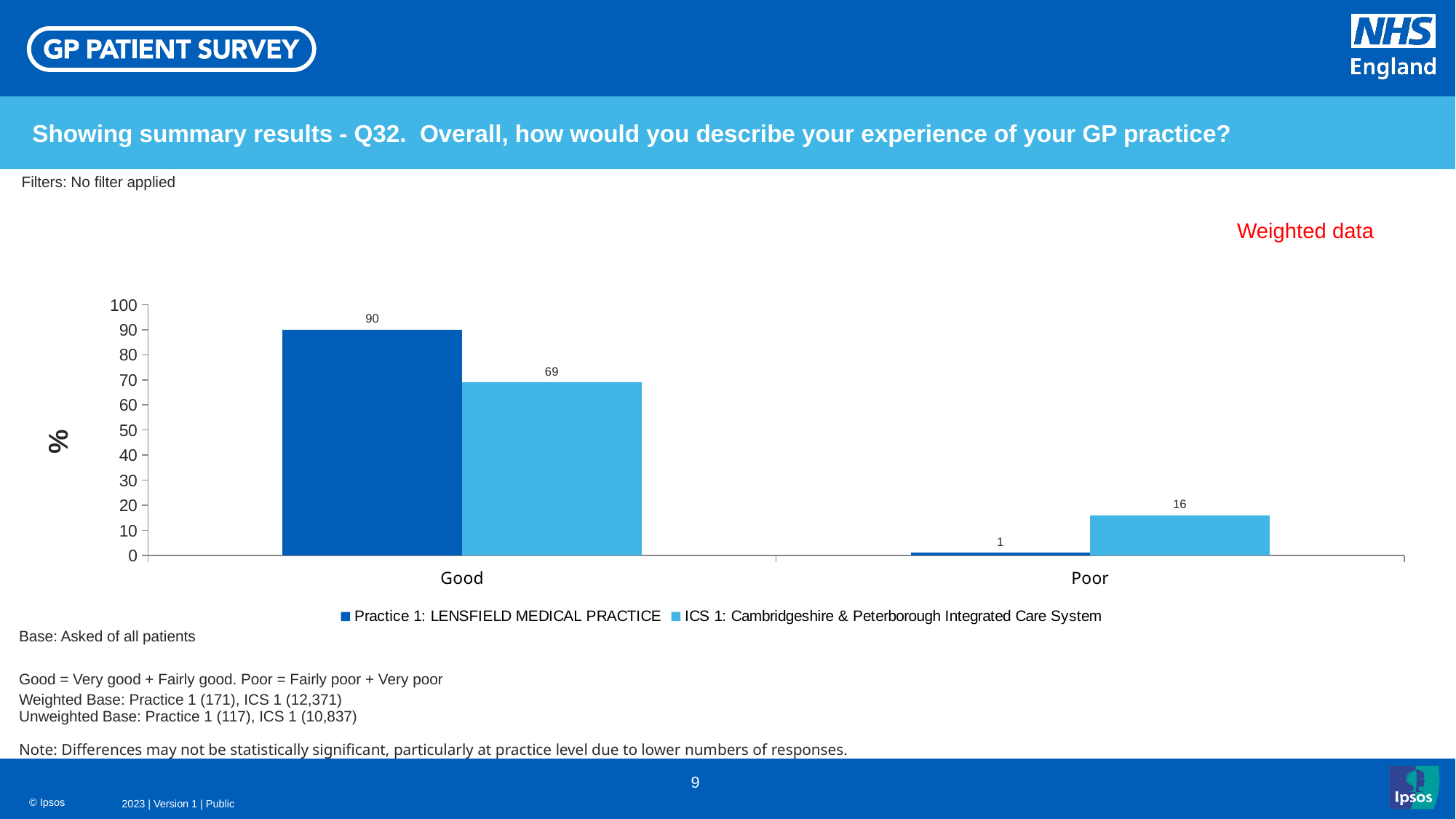
Which series has the lower value in the Poor category? Practice 1: LENSFIELD MEDICAL PRACTICE Which series has the higher value in the Good category? Practice 1: LENSFIELD MEDICAL PRACTICE What is the label on the vertical axis? % What is the difference between the ICS 1 and Practice 1 values in the Poor category? 15 What is the value for ICS 1: Cambridgeshire & Peterborough Integrated Care System in the Poor category? 16 What kind of chart is shown on the slide? Bar chart How many series does the legend list? 2 What is the difference between the Practice 1 and ICS 1 values in the Good category? 21 What is the value for Practice 1: LENSFIELD MEDICAL PRACTICE in the Good category? 90 What is the value for Practice 1: LENSFIELD MEDICAL PRACTICE in the Poor category? 1 How many categories are shown on the x axis? 2 What is the value for ICS 1: Cambridgeshire & Peterborough Integrated Care System in the Good category? 69